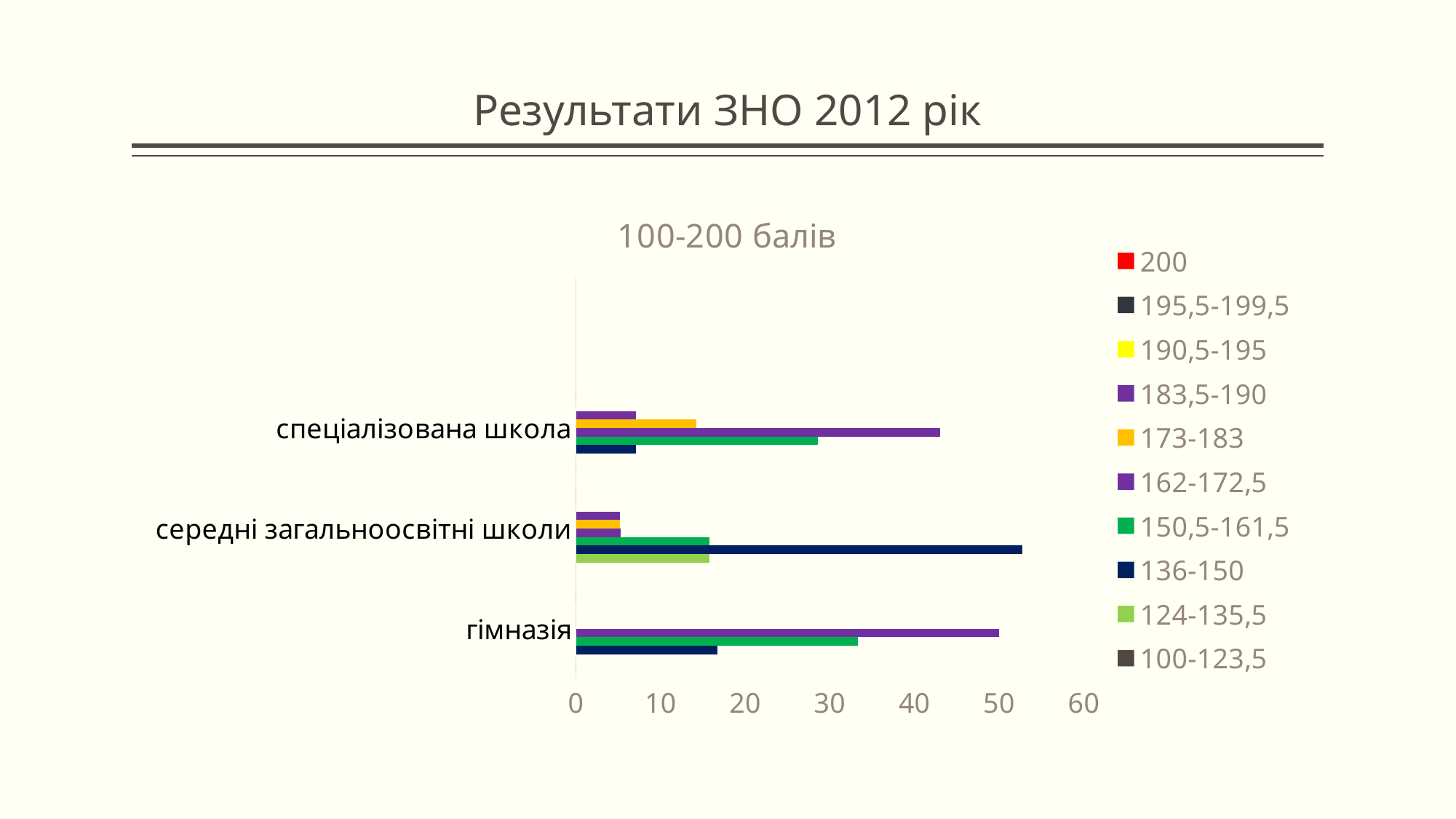
What is the title of the slide? Результати ЗНО 2012 рік What is the title of the chart? 100-200 балів Is the value for 173-183 for спеціалізована школа greater or less than 20? less Is the value for 162-172,5 for спеціалізована школа greater or less than 30? greater Which is larger for the 136-150 series: середні загальноосвітні школи or гімназія? середні загальноосвітні школи How many school categories are shown on the chart? 3 Is the value for 136-150 for середні загальноосвітні школи greater or less than 50? greater What kind of chart is shown on the slide? bar chart Which series has the highest value for гімназія? 162-172,5 How many series does the legend list? 10 Which series has the highest value for середні загальноосвітні школи? 136-150